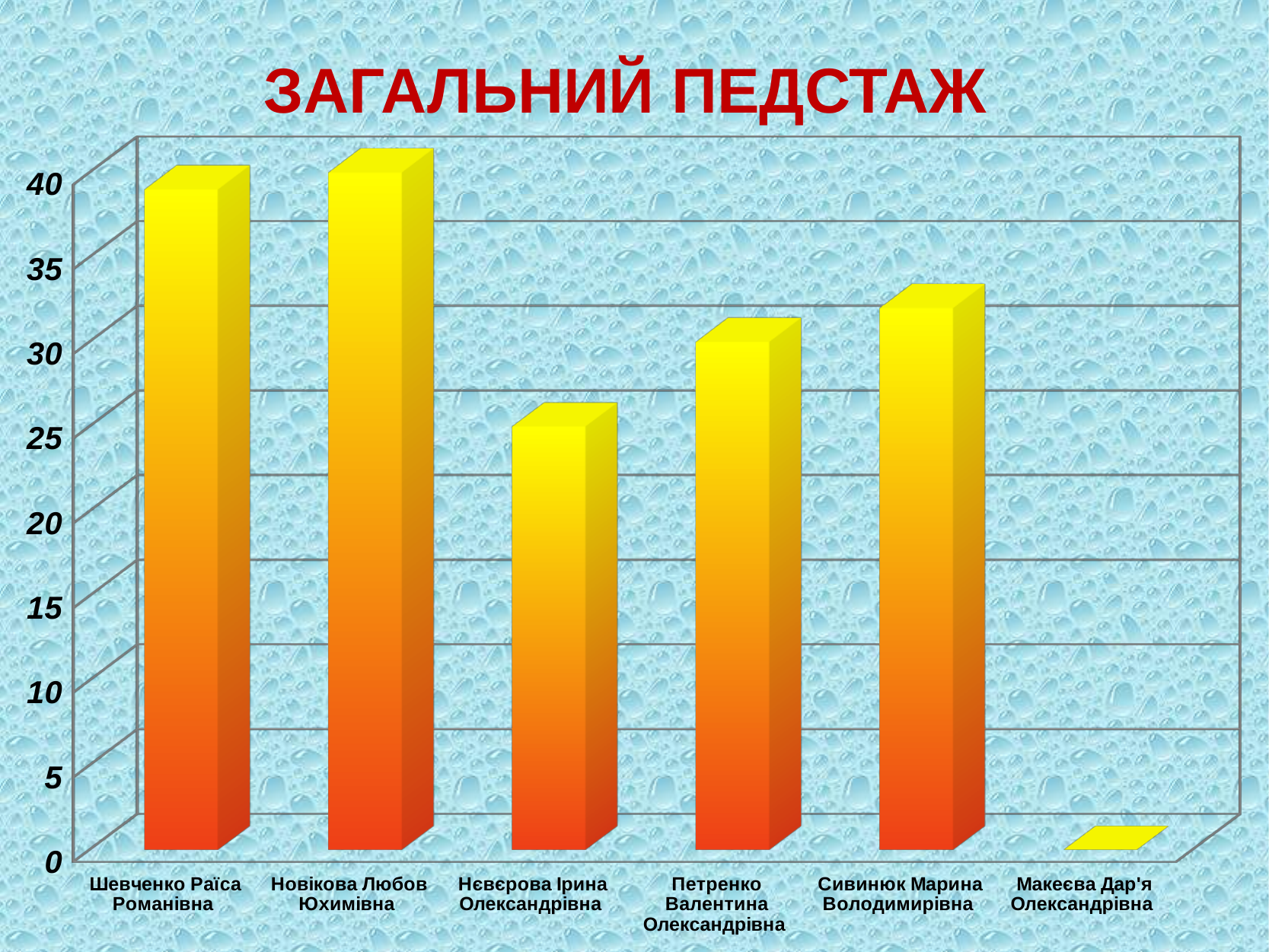
Is the value for Макеєва Дар'я Олександрівна greater or less than 5? less What is the title of the chart? ЗАГАЛЬНИЙ ПЕДСТАЖ Is the value for Шевченко Раїса Романівна greater or less than 35? greater Is the value for Нєвєрова Ірина Олександрівна greater or less than 30? less Which category has the lowest value in the chart? Макеєва Дар'я Олександрівна Which is larger: the value for Сивинюк Марина Володимирівна or the value for Петренко Валентина Олександрівна? Сивинюк Марина Володимирівна How many categories (people) are shown on the x axis of the chart? 6 Which is larger: the value for Шевченко Раїса Романівна or the value for Нєвєрова Ірина Олександрівна? Шевченко Раїса Романівна What kind of chart is shown on the slide? bar chart